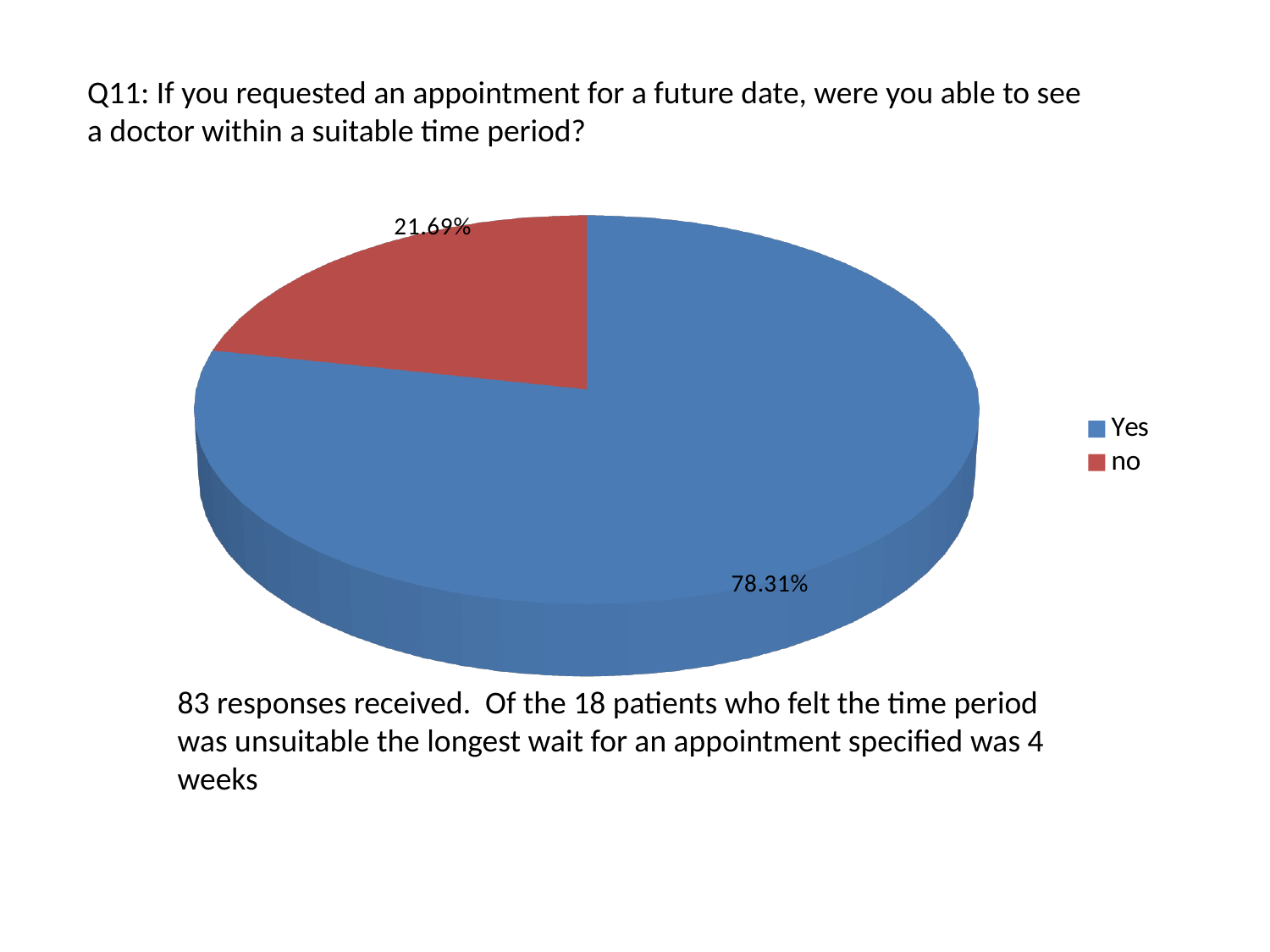
How many entries does the legend list? 2 What colour is the Yes slice? Blue What is the difference in percentage points between the Yes and no slices? 56.62 What kind of chart is shown on the slide? Pie chart What colour is the no slice? Red Which response has the largest share of the pie? Yes What percentage of respondents answered Yes? 78.31% What percentage of respondents answered no? 21.69% How many slices does the pie chart have? 2 Which response has the smallest share of the pie? no Which slice is larger, Yes or no? Yes What share of the pie does the no slice represent? 21.69%